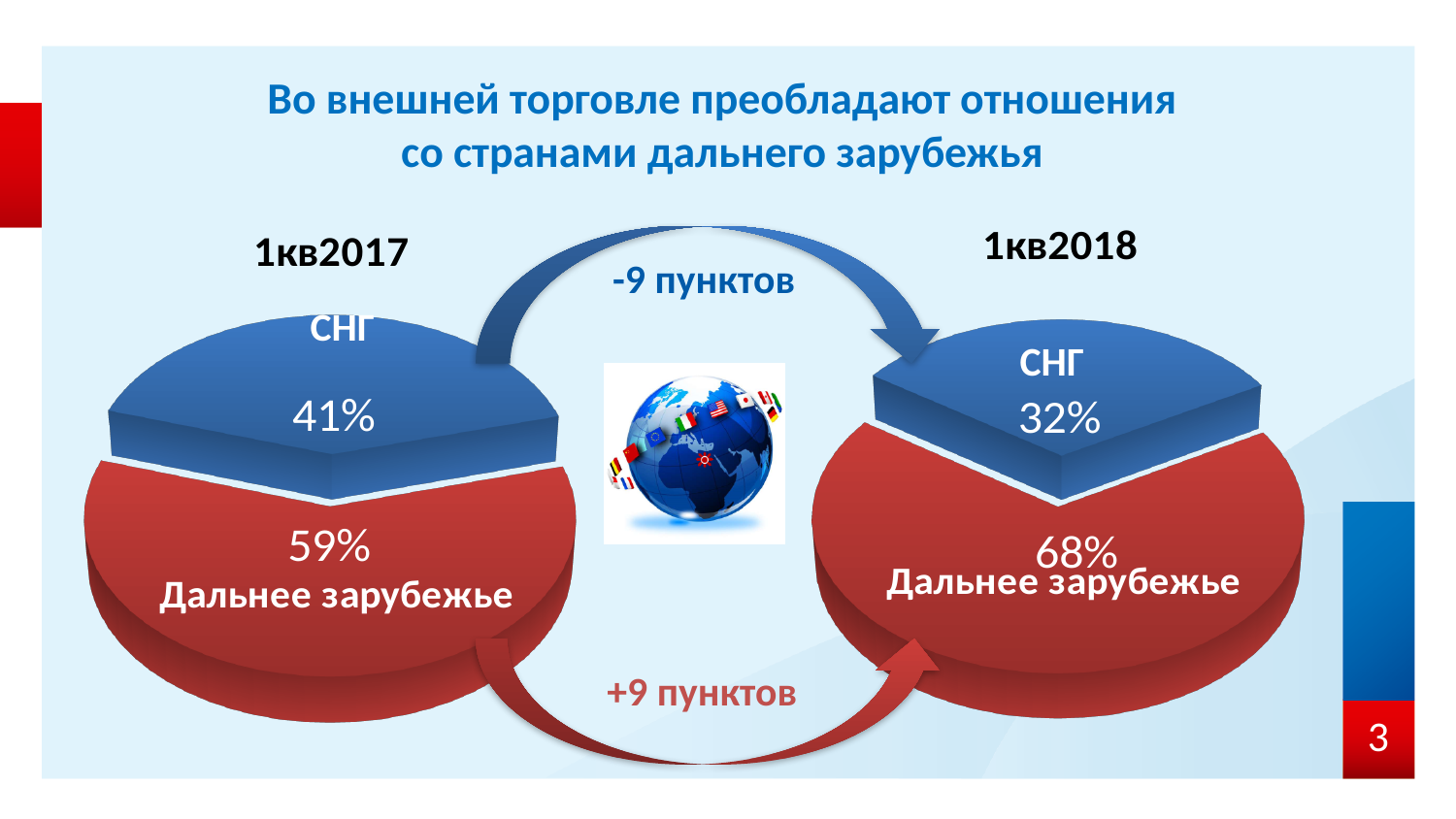
In the 1кв2017 pie chart, which slice is the smallest? СНГ Is the СНГ share larger in the 1кв2017 pie chart or in the 1кв2018 pie chart? 1кв2017 In the 1кв2017 pie chart, what share does СНГ have? 41% How many slices does the 1кв2018 pie chart have? 2 In the 1кв2018 pie chart, which slice is the largest? Дальнее зарубежье In the 1кв2017 pie chart, what is the difference between the Дальнее зарубежье share and the СНГ share? 18% What colour is the СНГ slice in the pie charts? Blue In the 1кв2017 pie chart, what share does Дальнее зарубежье have? 59% In the 1кв2018 pie chart, what is the difference between the Дальнее зарубежье share and the СНГ share? 36% What type of chart is used for 1кв2017 on the slide? Pie chart In the 1кв2018 pie chart, what share does СНГ have? 32% In the 1кв2018 pie chart, what share does Дальнее зарубежье have? 68%